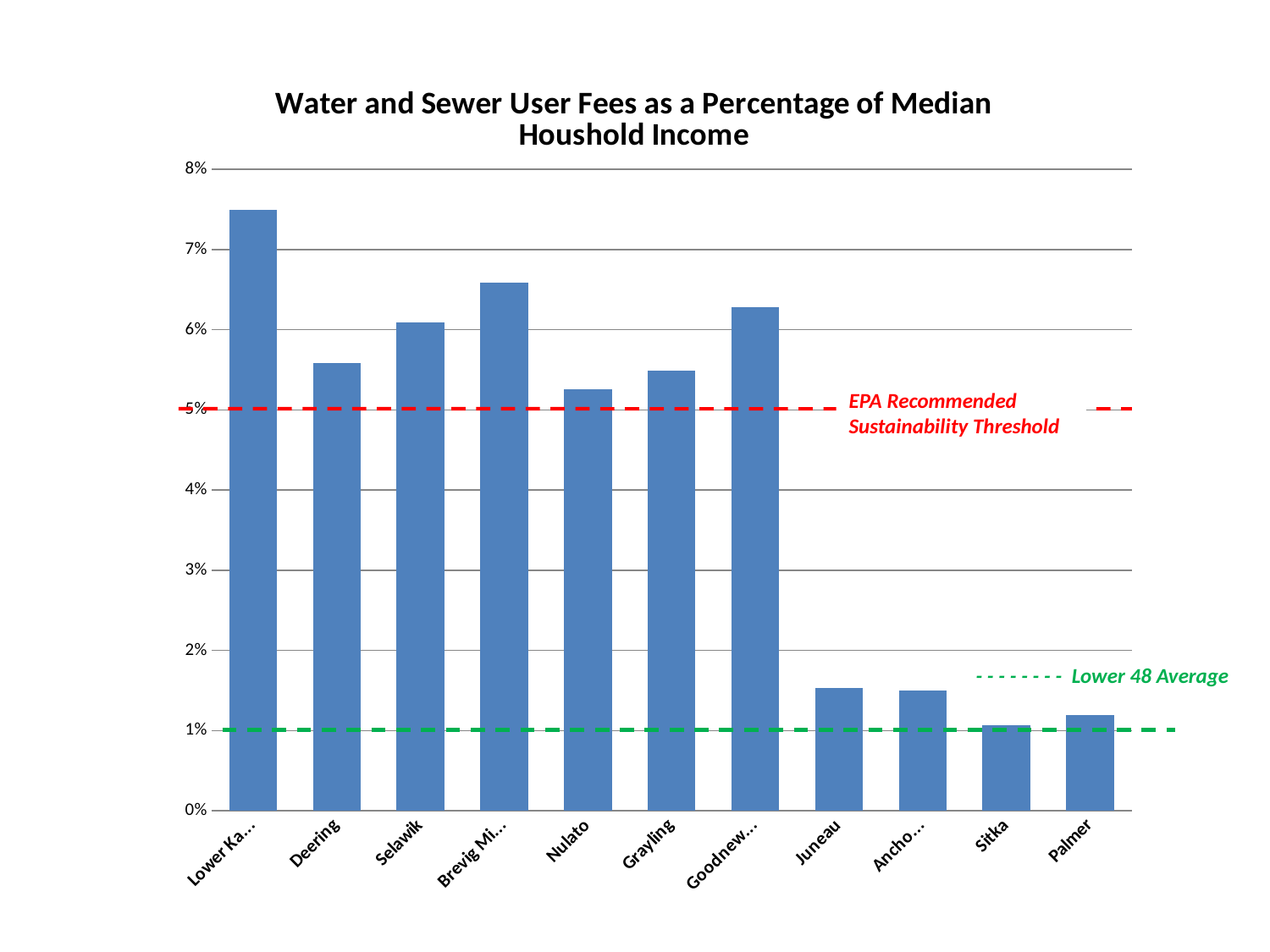
Is the value for Grayling greater or less than 5%? greater Which community has the lowest water and sewer user fees as a percentage of median household income? Sitka What does the green dashed line on the chart represent? Lower 48 Average How many communities (categories) are plotted on the x axis? 11 What does the red dashed line on the chart represent? EPA Recommended Sustainability Threshold Is the value for Palmer greater or less than 2%? less Is the value for Selawik greater or less than 5%? greater What kind of chart is shown on the slide? bar chart Which has the larger value, Juneau or Palmer? Juneau Which has the larger value, Deering or Selawik? Selawik